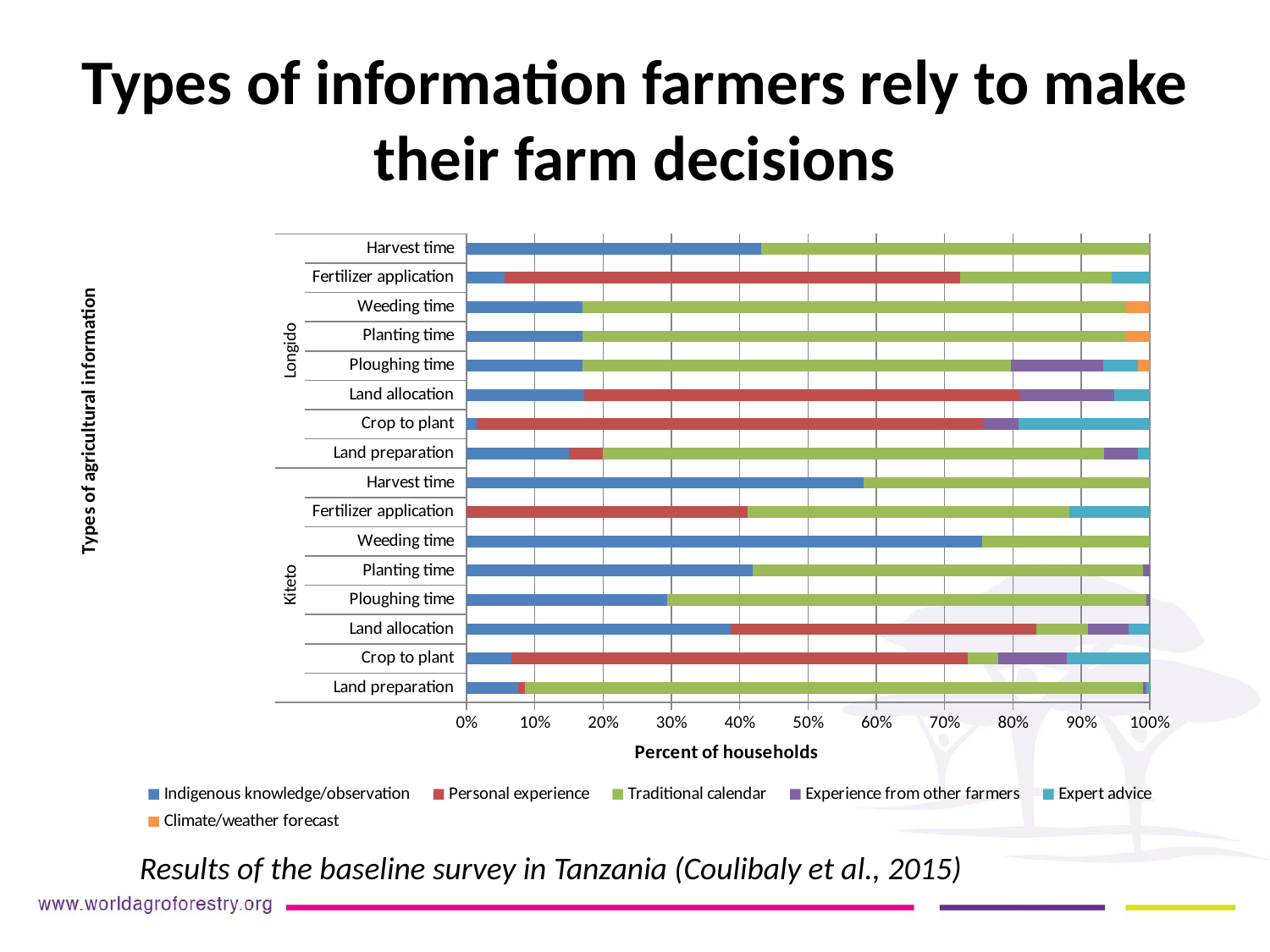
Is the Indigenous knowledge/observation share for Harvest time in Longido greater or less than 50%? less Which has the larger Indigenous knowledge/observation share for Harvest time: Longido or Kiteto? Kiteto How many bars (types of agricultural information across both districts) are plotted in the chart? 16 What kind of chart is shown on the slide? Stacked bar chart What is the title of the horizontal axis? Percent of households Which two districts are the bars grouped under? Longido and Kiteto Is the Indigenous knowledge/observation share for Fertilizer application in Longido greater or less than 10%? less Is the Indigenous knowledge/observation share for Harvest time in Kiteto greater or less than 50%? greater In Kiteto, which type of agricultural information has the largest Indigenous knowledge/observation share? Weeding time In Longido, which type of agricultural information has the largest Indigenous knowledge/observation share? Harvest time How many series does the legend list? 6